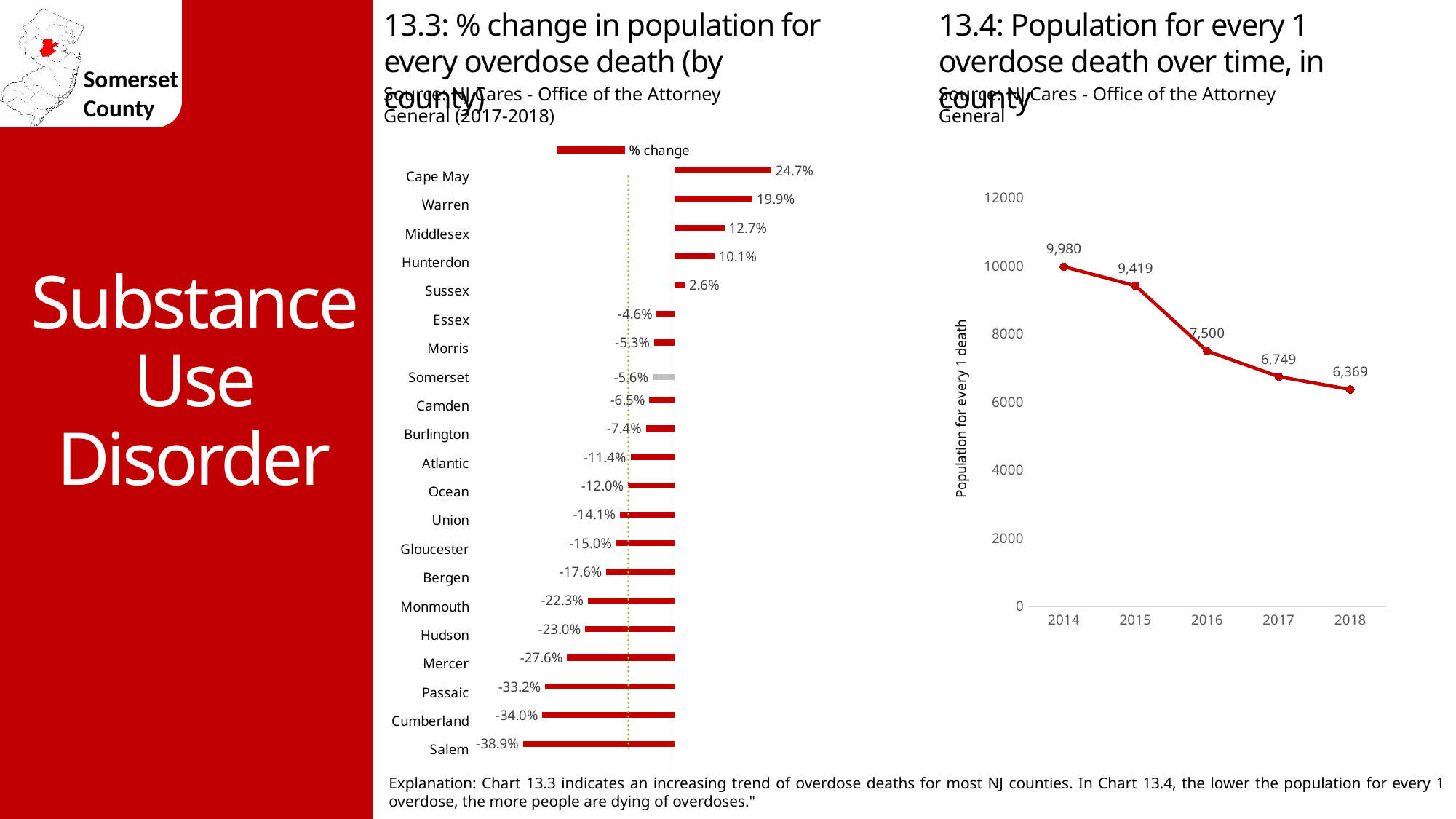
In chart 13.4, what is the population for every 1 overdose death in 2016? 7,500 In chart 13.3, what is the difference between the % change for Cape May and Warren? 4.8% In chart 13.3, what is the % change for Hunterdon? 10.1% In chart 13.3, how many counties are shown? 21 What kind of chart is chart 13.4? line chart In chart 13.4, do the values rise or fall from 2014 to 2018? fall In chart 13.3, what is the % change for Somerset? -5.6% In chart 13.4, which year has the lowest population for every 1 overdose death? 2018 In chart 13.3, which county has the lowest % change? Salem In chart 13.3, which has a larger % change, Middlesex or Sussex? Middlesex In chart 13.4, what is the difference between the 2014 and 2018 values? 3,611 In chart 13.3, which county has the highest % change? Cape May